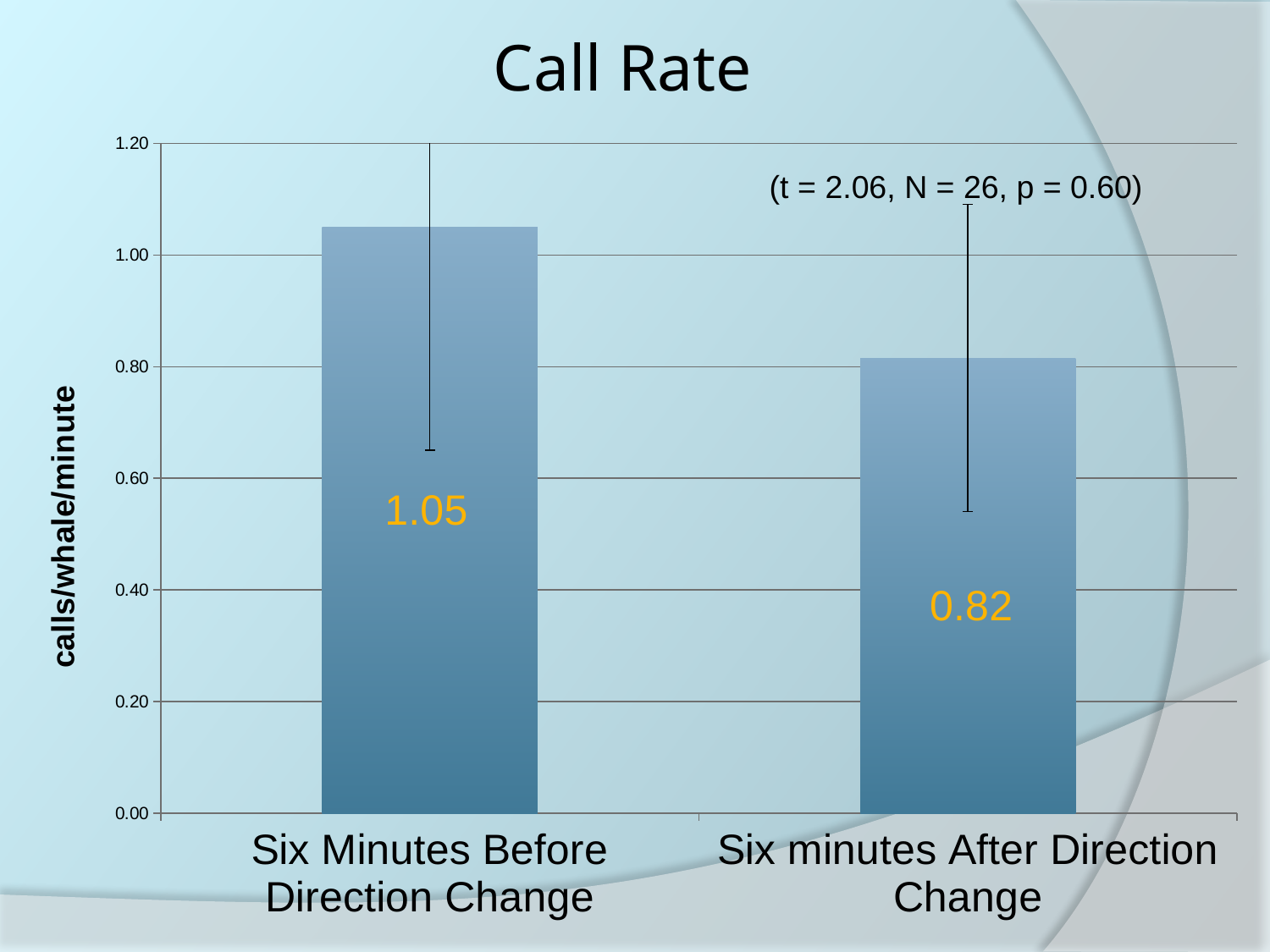
What is the title of the chart? Call Rate Which category has the higher call rate? Six Minutes Before Direction Change What is the call rate for Six Minutes Before Direction Change? 1.05 What is the label of the vertical axis? calls/whale/minute What type of chart is shown on the slide? Bar chart Is the value for Six Minutes Before Direction Change greater or less than 1.00? greater What is the call rate for Six minutes After Direction Change? 0.82 What is the difference in call rate between Six Minutes Before Direction Change and Six minutes After Direction Change? 0.23 Is the call rate higher before or after the direction change? Before Which category has the lower call rate? Six minutes After Direction Change Is the value for Six minutes After Direction Change greater or less than 1.00? less How many categories are shown in the chart? 2